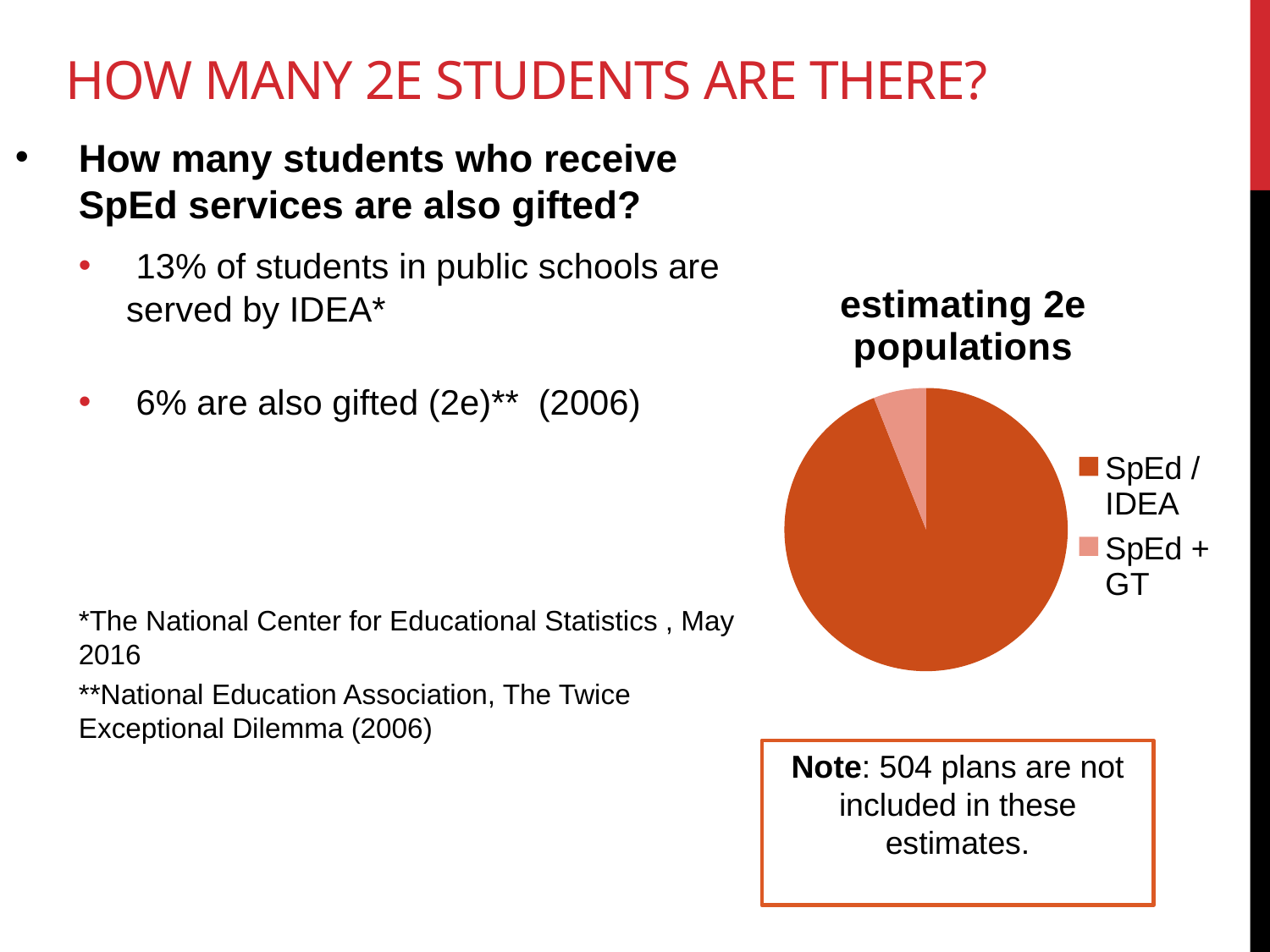
Which slice of the pie chart is the smallest? SpEd + GT How many entries does the legend of the pie chart list? 2 What is the title of the pie chart? estimating 2e populations Which slice is larger in the pie chart, SpEd / IDEA or SpEd + GT? SpEd / IDEA Which legend entry is shown in the lighter orange colour in the pie chart? SpEd + GT What kind of chart is shown on the slide? pie chart Which slice of the pie chart is the largest? SpEd / IDEA How many slices does the pie chart have? 2 Does the SpEd + GT slice take up more or less than half of the pie chart? less Does the SpEd / IDEA slice take up more or less than half of the pie chart? more